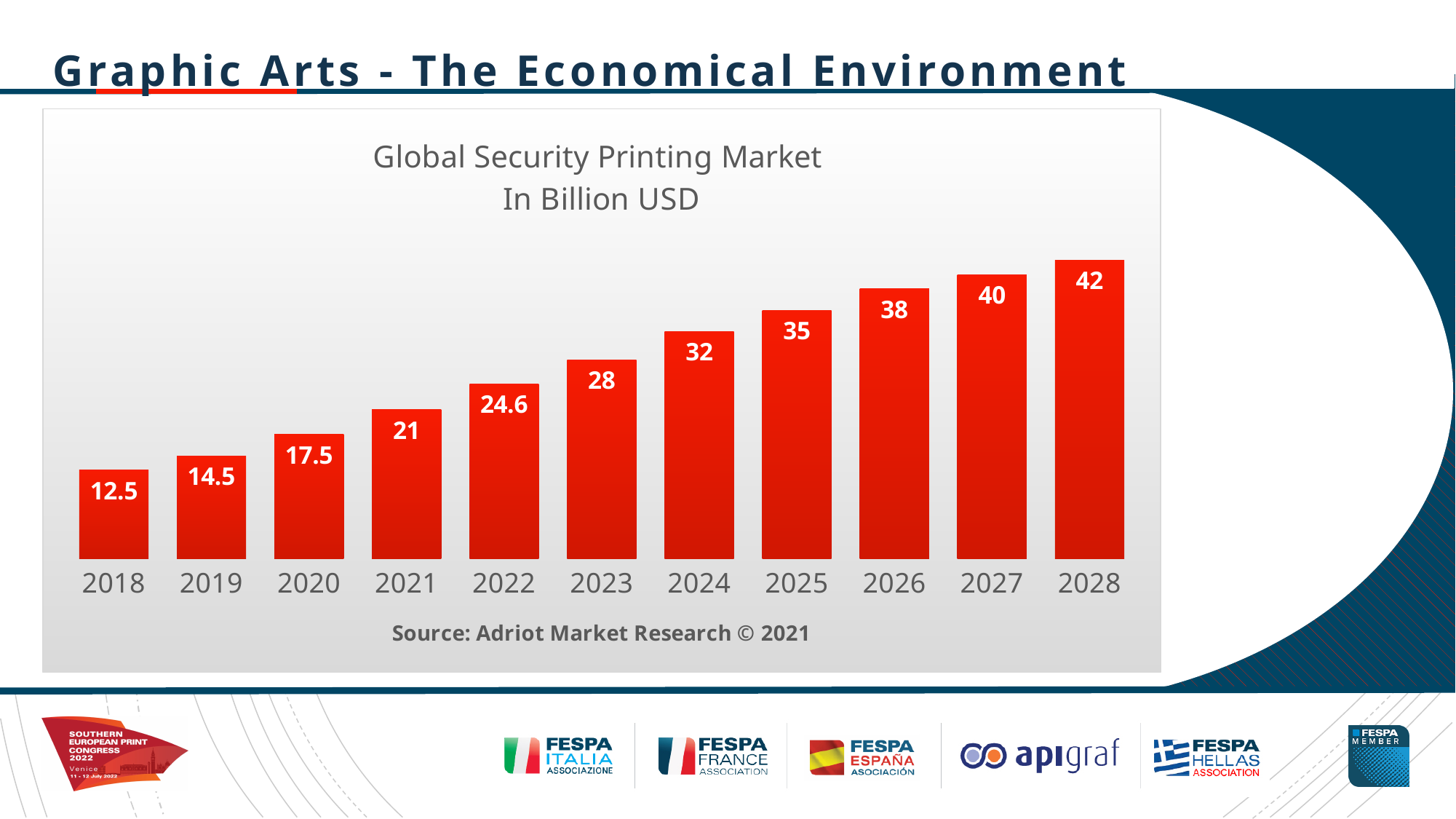
Do the values rise or fall from 2018 to 2028? Rise What is the difference between the values for 2028 and 2018? 29.5 What is the value for 2022? 24.6 What kind of chart is this? Bar chart What is the difference between the values for 2023 and 2022? 3.4 What is the title of the chart? Global Security Printing Market In Billion USD Which is larger, the value for 2024 or the value for 2021? 2024 What is the value for 2027? 40 Which year has the lowest value? 2018 Which year has the highest value? 2028 What is the value for 2018? 12.5 How many years are shown on the x axis? 11